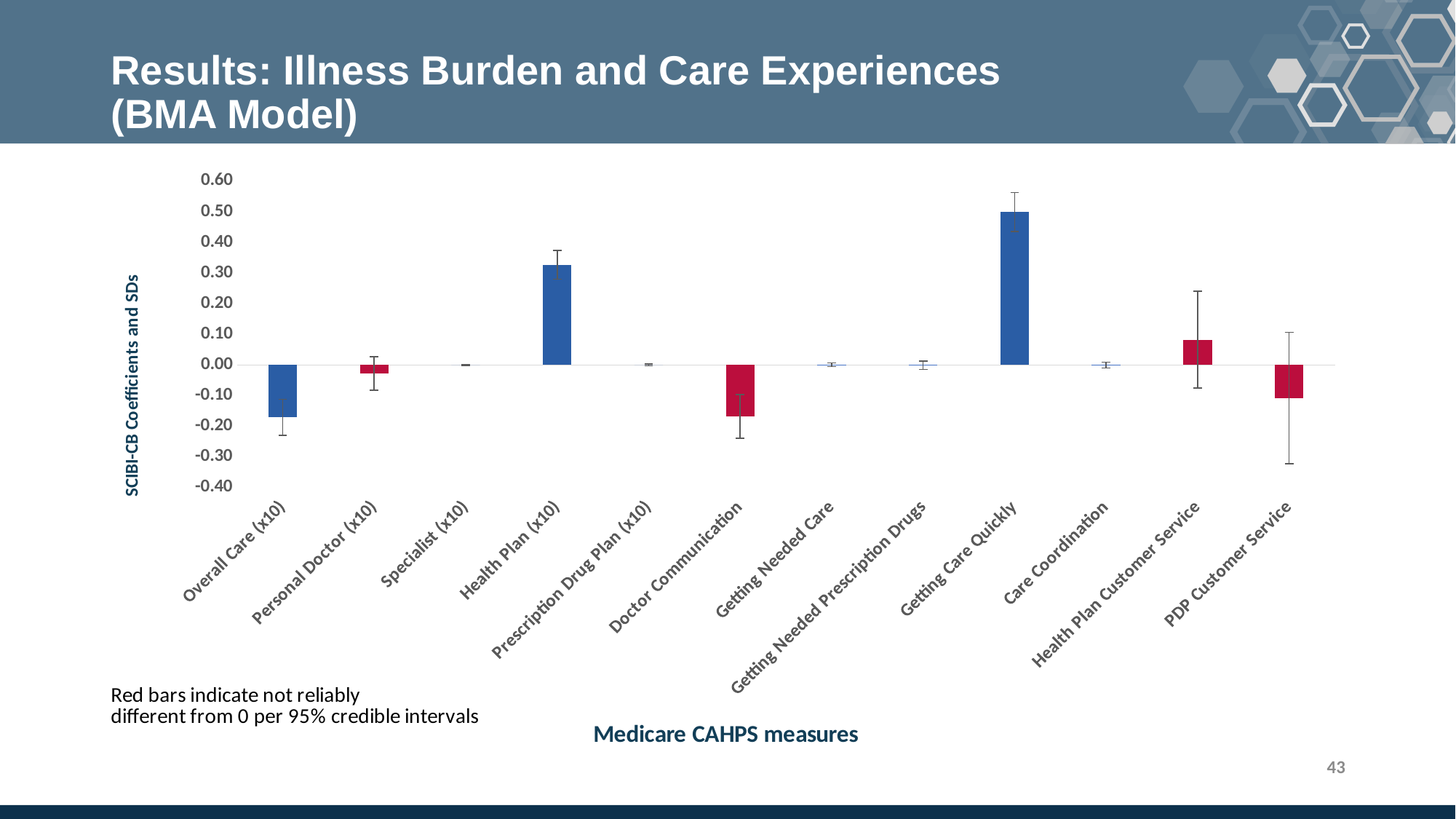
Is the value for Getting Care Quickly greater or less than 0.40? greater According to the note on the slide, what do red bars indicate? Not reliably different from 0 per 95% credible intervals Is the value for Doctor Communication greater or less than -0.10? less Which is larger, the value for Health Plan (x10) or the value for Getting Care Quickly? Getting Care Quickly Is the value for Health Plan Customer Service greater or less than 0.20? less What kind of chart is shown on the slide? bar chart How many Medicare CAHPS measures are plotted along the x axis? 12 Which is larger, the value for Health Plan Customer Service or the value for PDP Customer Service? Health Plan Customer Service Which measure has the highest SCIBI-CB coefficient? Getting Care Quickly What is the title of the y axis? SCIBI-CB Coefficients and SDs